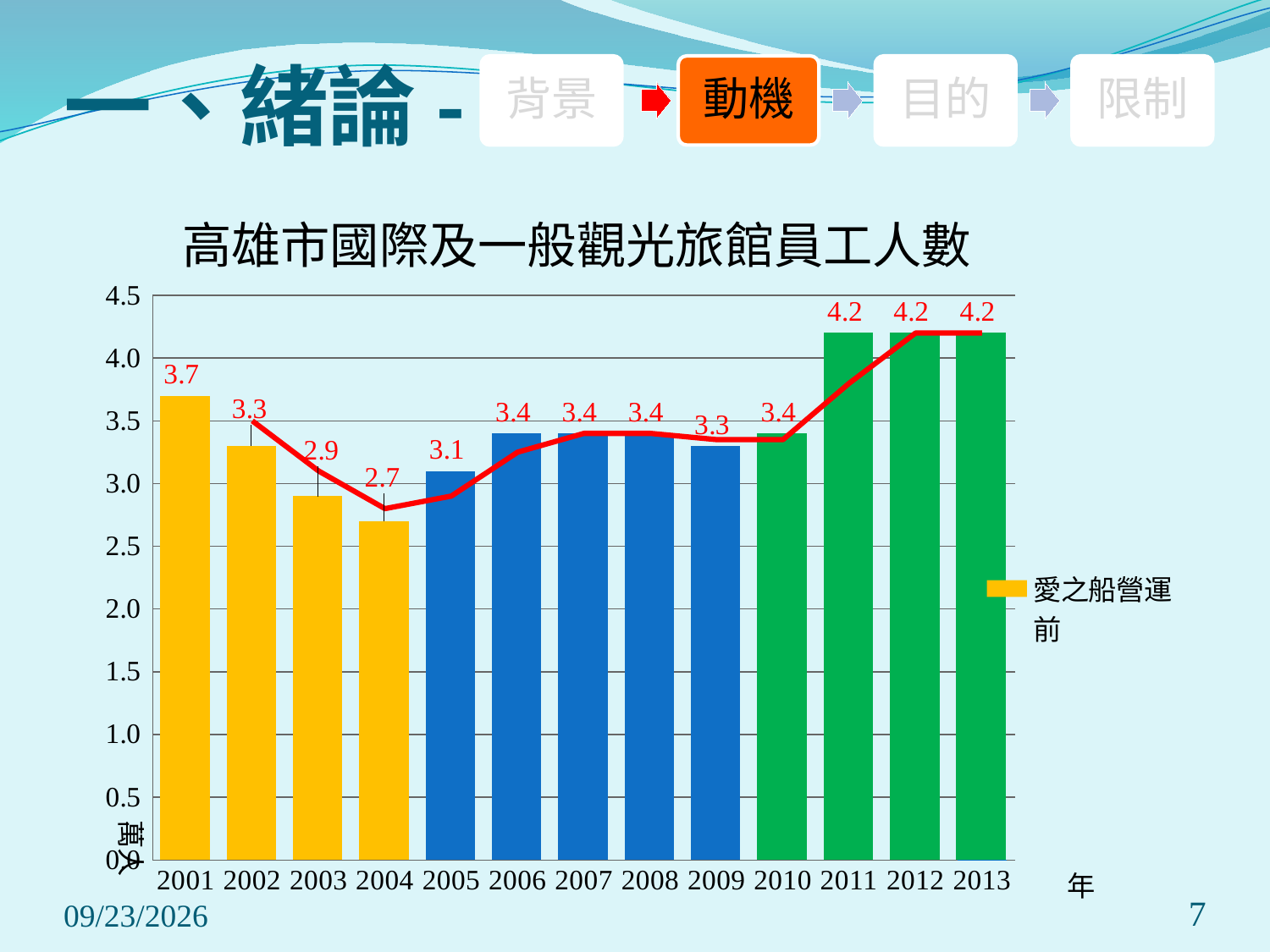
What is the value for 2004? 2.7 Is the value for 2011 greater or less than 4.0? greater Which is larger, the value for 2001 or the value for 2002? 2001 What kind of chart is this? bar chart with a line Which year has the lowest value? 2004 What is the title of the chart? 高雄市國際及一般觀光旅館員工人數 How many years are shown on the x axis? 13 What is the difference between the values for 2001 and 2004? 1.0 What is the value for 2009? 3.3 What is the value for 2001? 3.7 Do the values rise or fall from 2001 to 2004? fall What is the value for 2012? 4.2